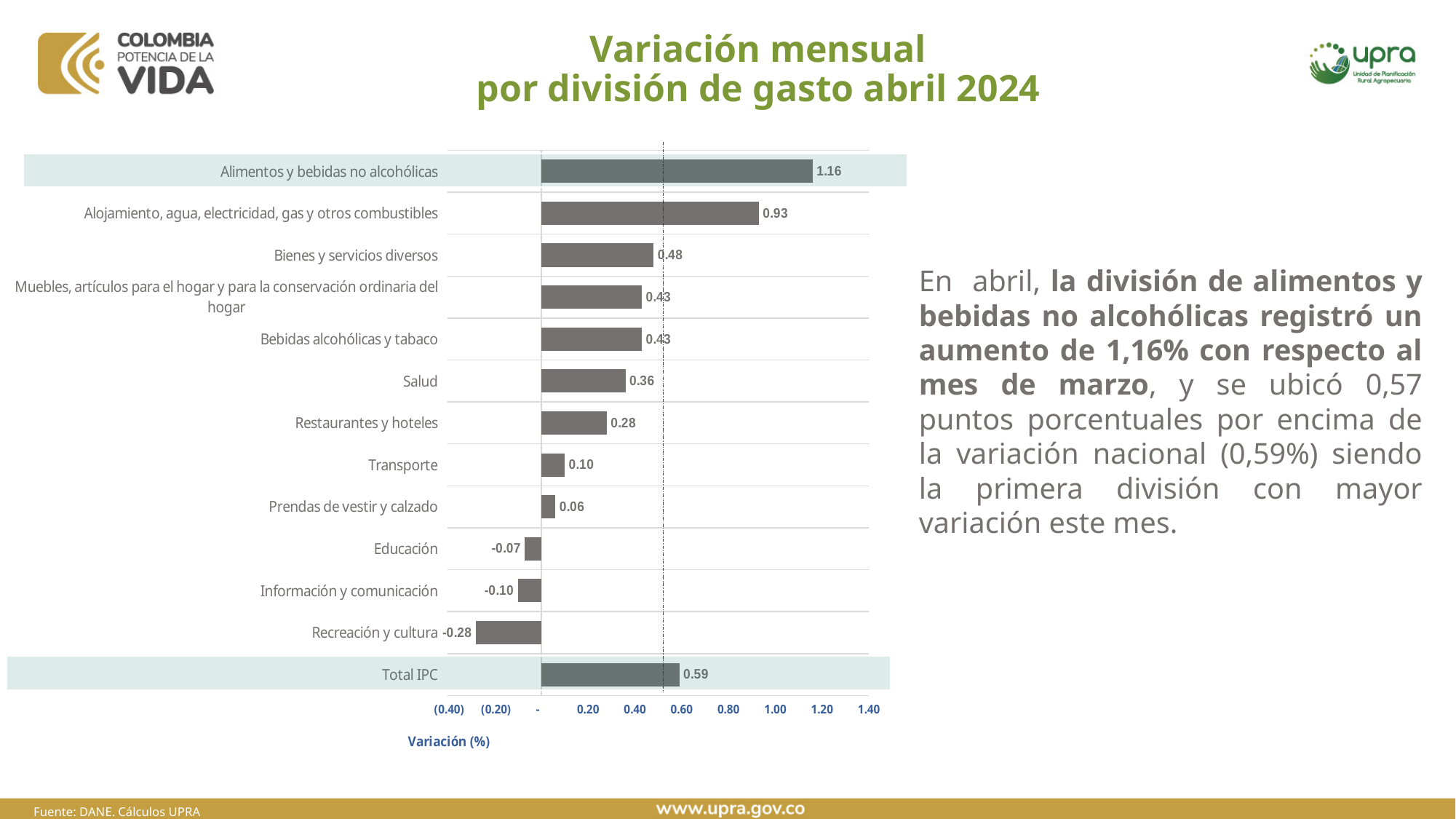
What is the value for Recreación y cultura? -0.28 What is the difference between the values for Alimentos y bebidas no alcohólicas and Total IPC? 0.57 What is the value shown for Total IPC? 0.59 What is the label of the horizontal axis? Variación (%) How many divisions have a negative monthly variation? 3 How many categories (bars) are shown in the chart, including Total IPC? 13 Which division has the highest monthly variation? Alimentos y bebidas no alcohólicas What kind of chart is shown on the slide? Bar chart What is the value for Transporte? 0.10 Which division has the lowest monthly variation? Recreación y cultura What is the monthly variation for Alimentos y bebidas no alcohólicas? 1.16 Which is larger, the value for Salud or the value for Restaurantes y hoteles? Salud